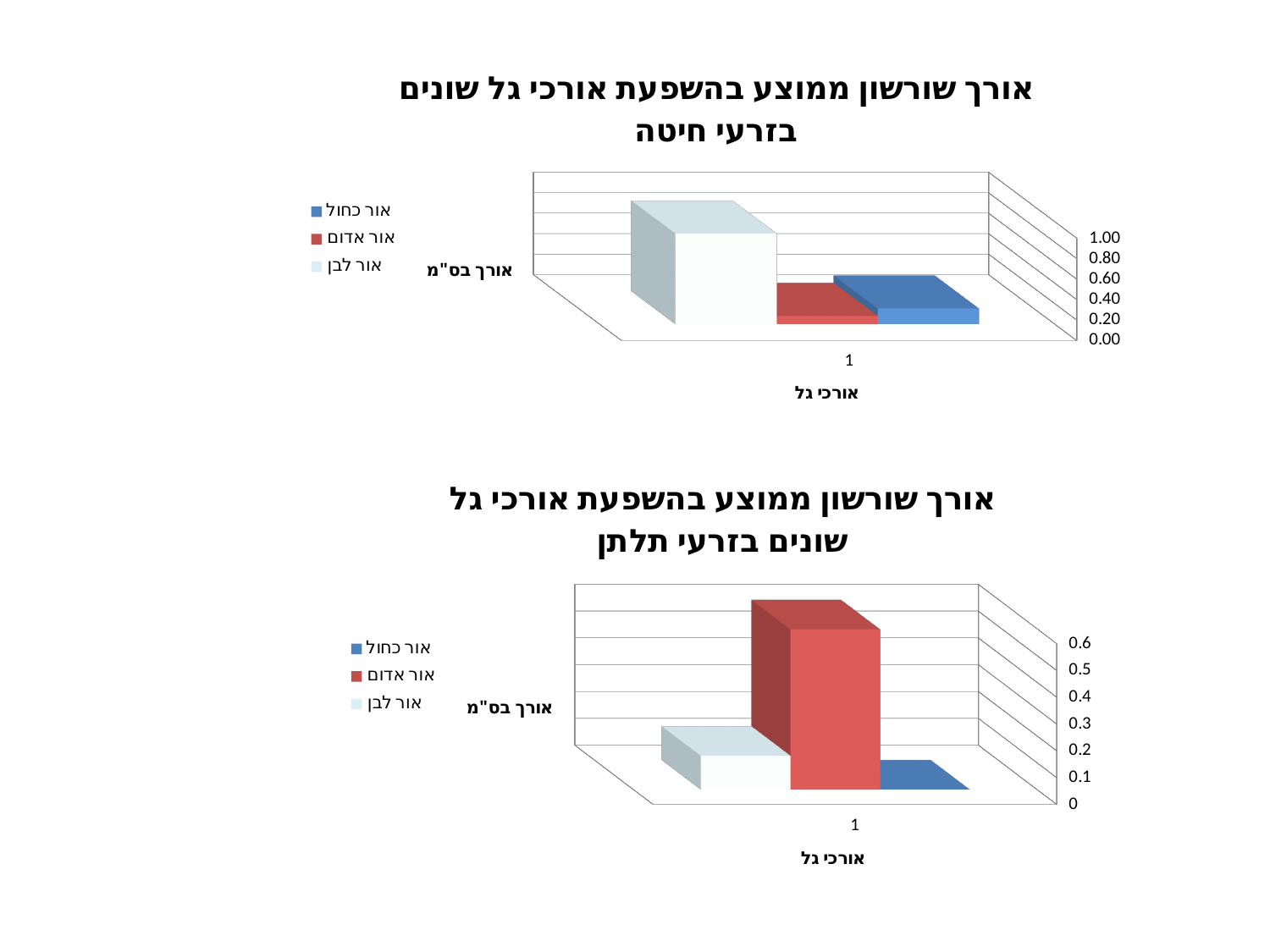
In the top chart (wheat seeds), which is larger, the value for אור לבן or the value for אור אדום? אור לבן What kind of chart is the top chart (wheat seeds)? bar chart How many series does the legend of the top chart (wheat seeds) list? 3 What is the label of the vertical axis in the top chart (wheat seeds)? אורך בס"מ How many categories are shown on the x axis of the bottom chart (clover seeds)? 1 In the bottom chart (clover seeds), is the value for אור כחול greater or less than 0.2? less In the bottom chart (clover seeds), which series has the lowest bar? אור כחול In the top chart (wheat seeds), which series has the highest bar? אור לבן In the top chart (wheat seeds), is the value for אור לבן greater or less than 0.60? greater In the bottom chart (clover seeds), is the value for אור אדום greater or less than 0.4? greater In the bottom chart (clover seeds), which series has the highest bar? אור אדום